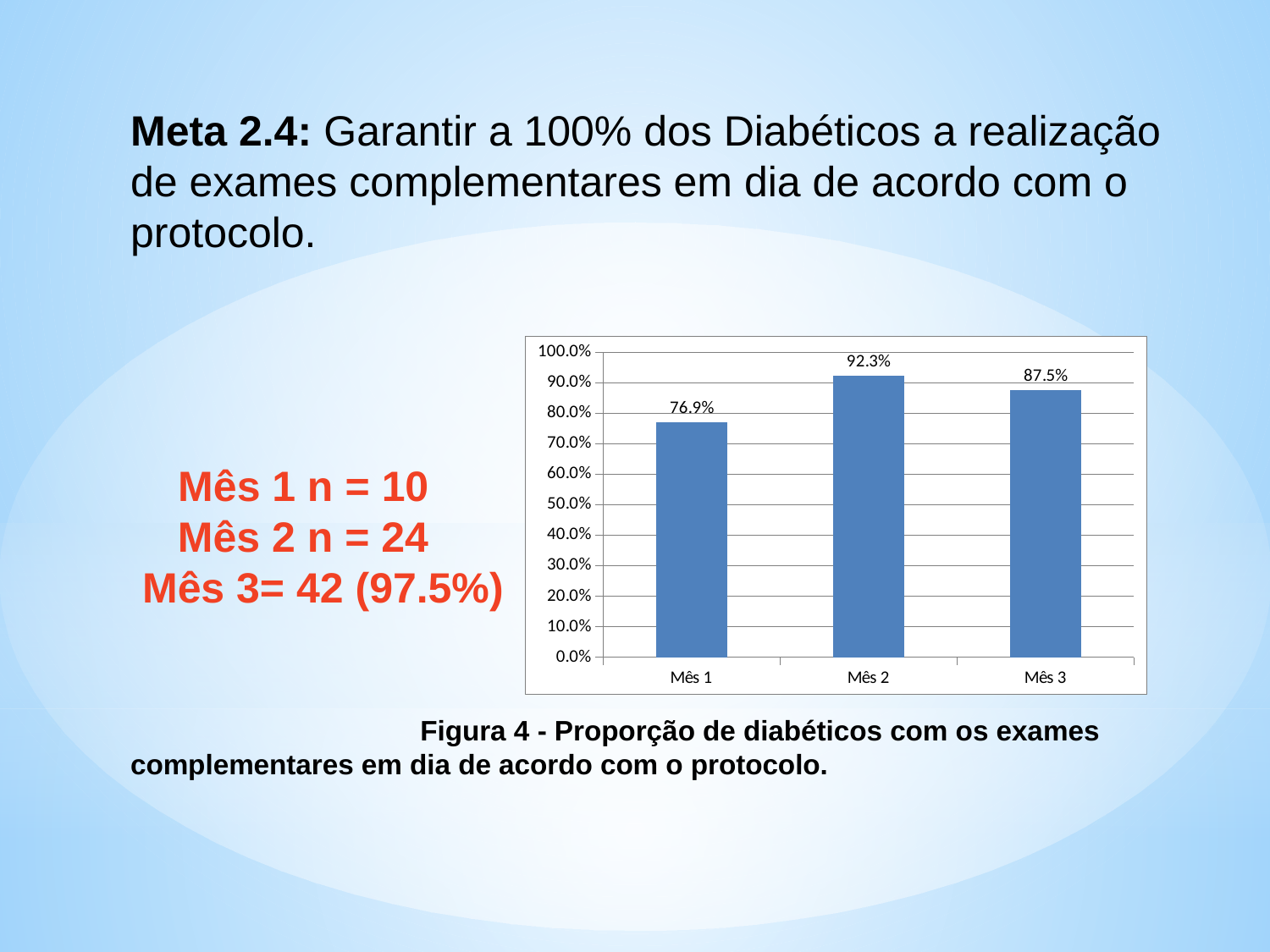
What kind of chart is shown on the slide? bar chart What is the value for Mês 3? 87.5% What is the value for Mês 1? 76.9% Is the value for Mês 1 greater or less than 80.0%? less Which month has the lowest value? Mês 1 Which is larger, the value for Mês 3 or the value for Mês 1? Mês 3 What is the difference between the values for Mês 2 and Mês 1? 15.4% How many months are shown on the x axis? 3 What is the value for Mês 2? 92.3% What is the difference between the values for Mês 2 and Mês 3? 4.8% Which month has the highest value? Mês 2 What is the figure caption below the chart? Figura 4 - Proporção de diabéticos com os exames complementares em dia de acordo com o protocolo.